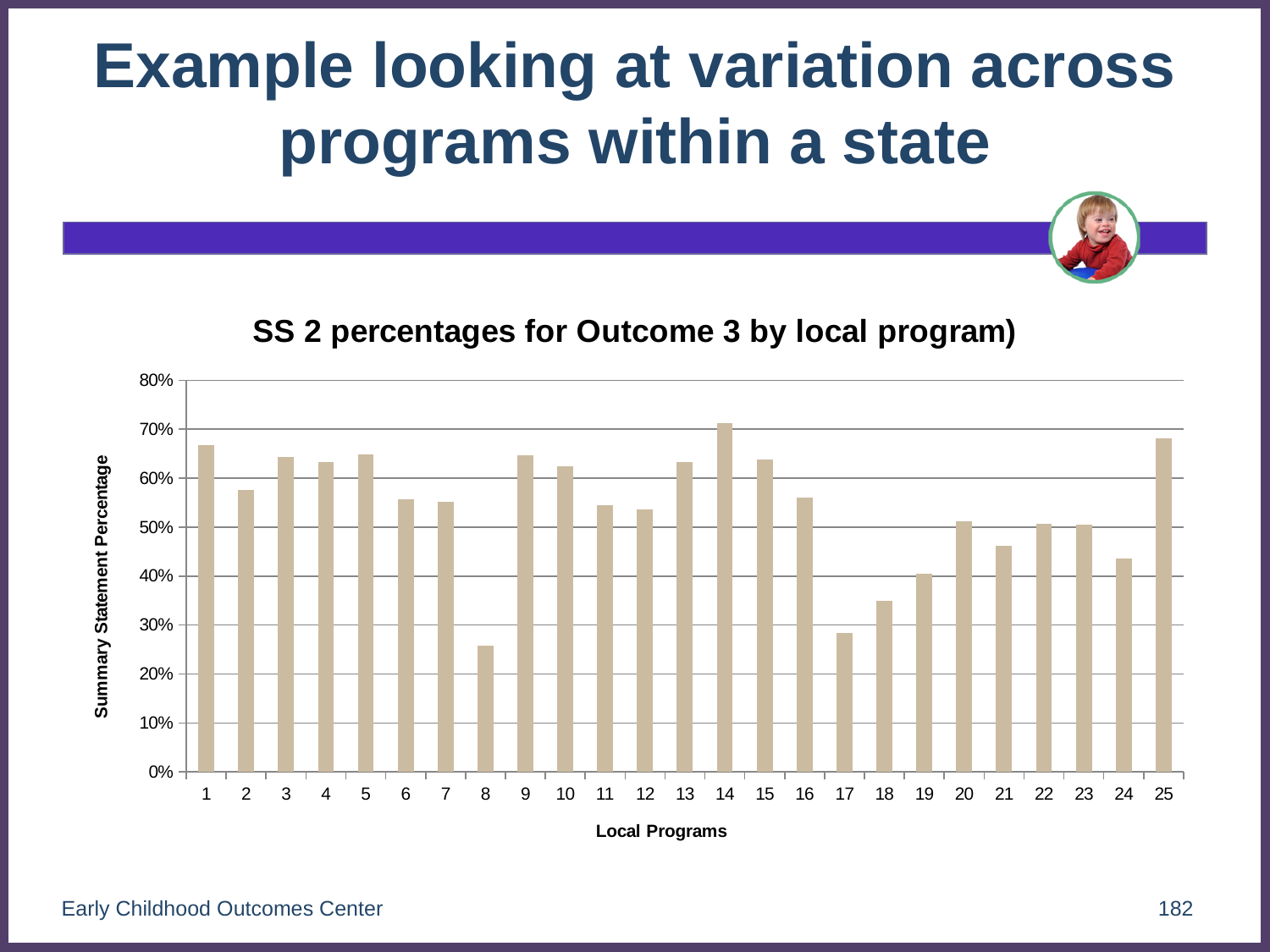
What kind of chart is shown on the slide? bar chart Which local program has the lowest Summary Statement Percentage? 8 Which local program has the highest Summary Statement Percentage? 14 Is the value for local program 1 greater or less than 60%? greater What is the title of the chart? SS 2 percentages for Outcome 3 by local program) Is the value for local program 8 greater or less than 30%? less How many local programs are plotted on the x axis? 25 Is the value for local program 14 greater or less than 70%? greater Which has a larger Summary Statement Percentage, local program 25 or local program 17? 25 What is the label on the vertical axis of the chart? Summary Statement Percentage